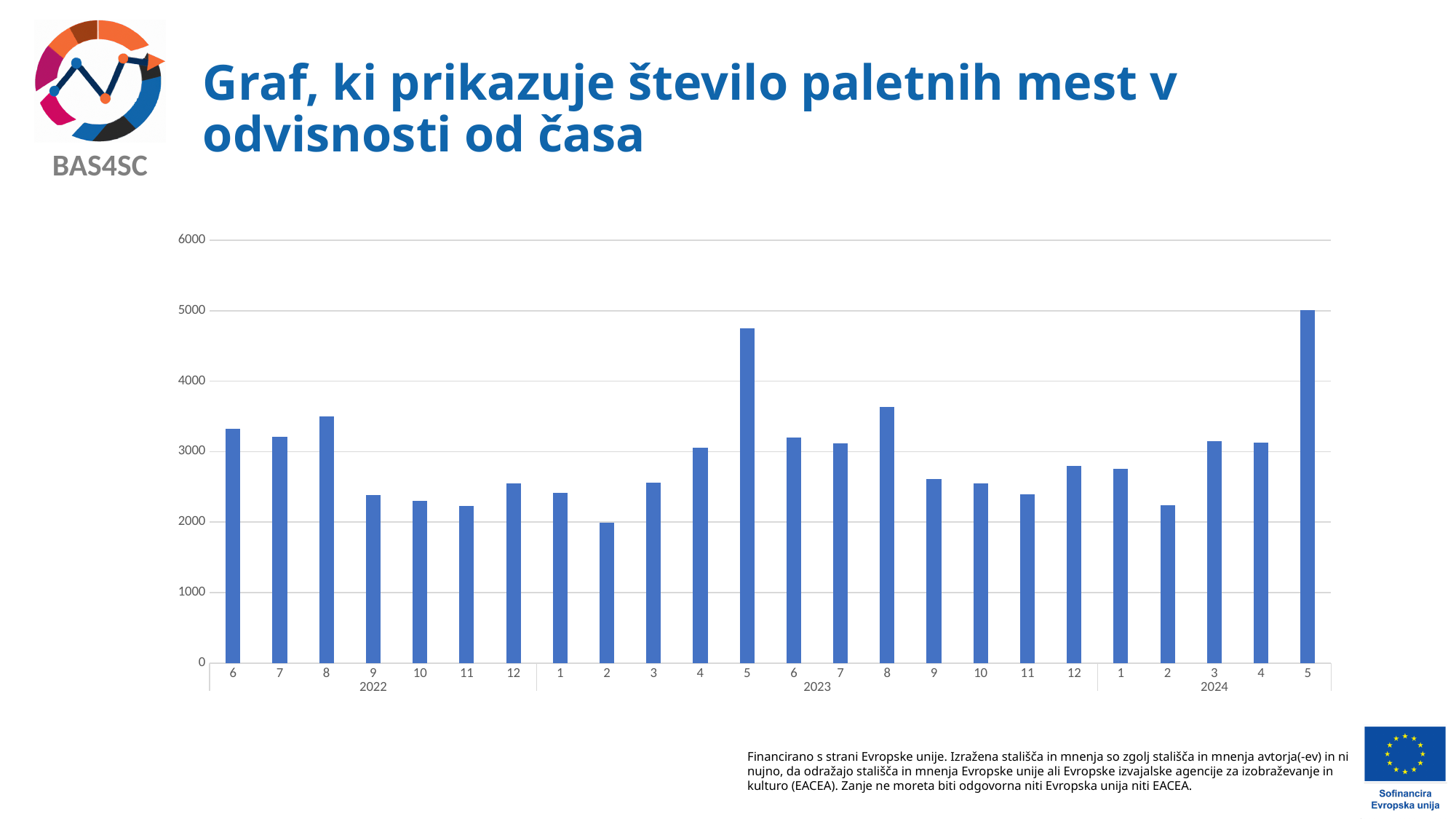
Do the values rise or fall from month 2 of 2023 to month 5 of 2023? rise Is the value for month 11 of 2022 greater or less than 2500? less Is the value for month 6 of 2022 greater or less than 3000? greater Which month has the highest number of pallet places in the chart? 5 (2024) Is the value for month 2 of 2023 greater or less than 2500? less Which is larger, the value for month 5 of 2023 or the value for month 8 of 2023? month 5 of 2023 Which month has the lowest number of pallet places in the chart? 2 (2023) What kind of chart is shown on the slide? bar chart Which is larger, the value for month 12 of 2022 or the value for month 12 of 2023? month 12 of 2023 How many bars (months) are plotted in the chart? 24